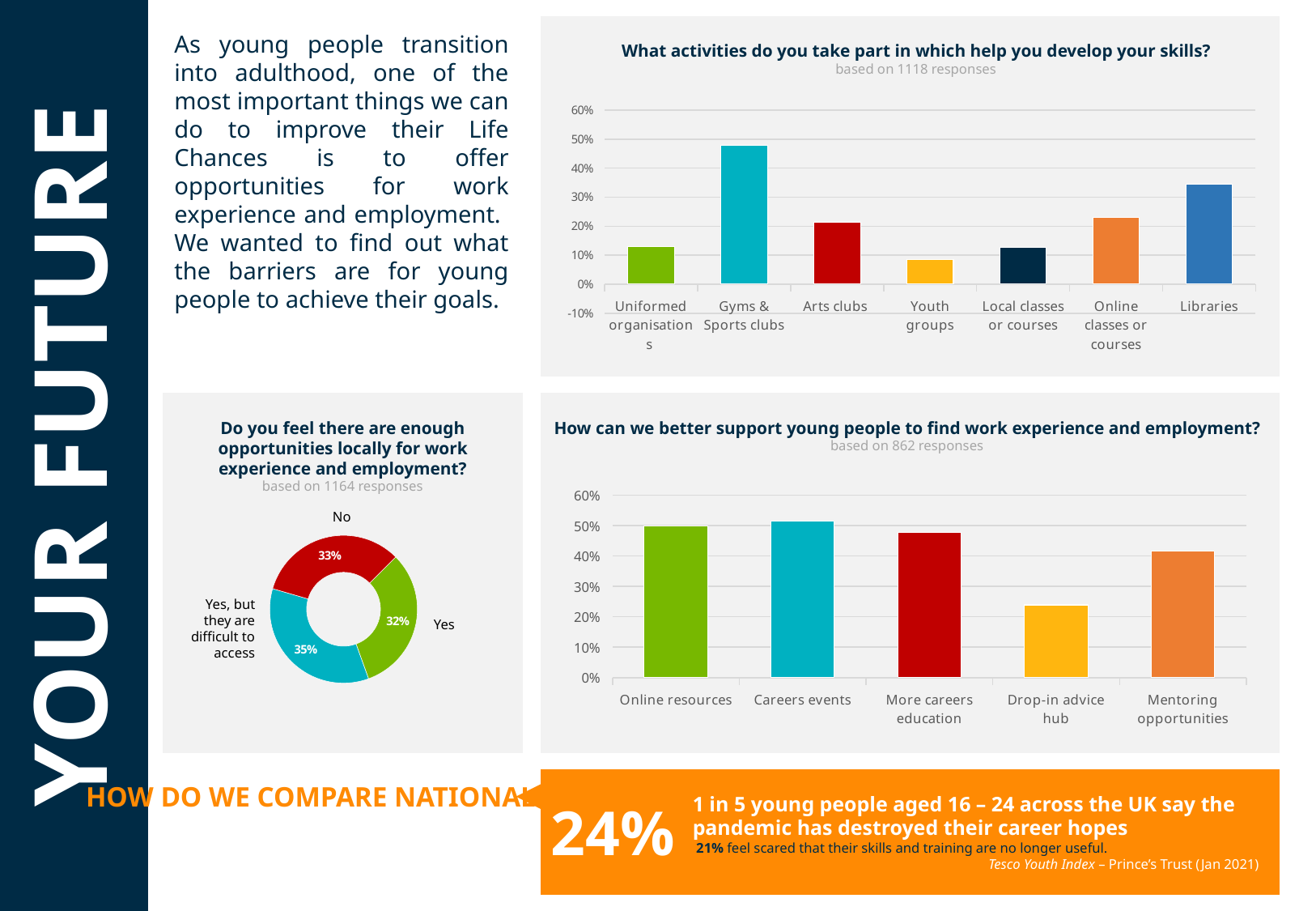
In the chart titled "How can we better support young people to find work experience and employment?", which option has the lowest value? Drop-in advice hub What type of chart is the chart titled "How can we better support young people to find work experience and employment?"? Bar chart In the chart titled "What activities do you take part in which help you develop your skills?", which activity has the highest value? Gyms & Sports clubs In the donut chart titled "Do you feel there are enough opportunities locally for work experience and employment?", what share answered "Yes, but they are difficult to access"? 35% In the donut chart titled "Do you feel there are enough opportunities locally for work experience and employment?", what is the difference between the "Yes, but they are difficult to access" share and the "Yes" share? 3% In the chart titled "What activities do you take part in which help you develop your skills?", which activity has the lowest value? Youth groups In the chart titled "What activities do you take part in which help you develop your skills?", is the value for Libraries greater or less than 30%? greater In the chart titled "What activities do you take part in which help you develop your skills?", how many activity categories are shown? 7 In the chart titled "What activities do you take part in which help you develop your skills?", which is larger: Online classes or courses, or Local classes or courses? Online classes or courses In the chart titled "What activities do you take part in which help you develop your skills?", is the value for Arts clubs greater or less than 30%? less In the chart titled "How can we better support young people to find work experience and employment?", is the value for Mentoring opportunities greater or less than 30%? greater In the donut chart titled "Do you feel there are enough opportunities locally for work experience and employment?", what share answered "No"? 33%